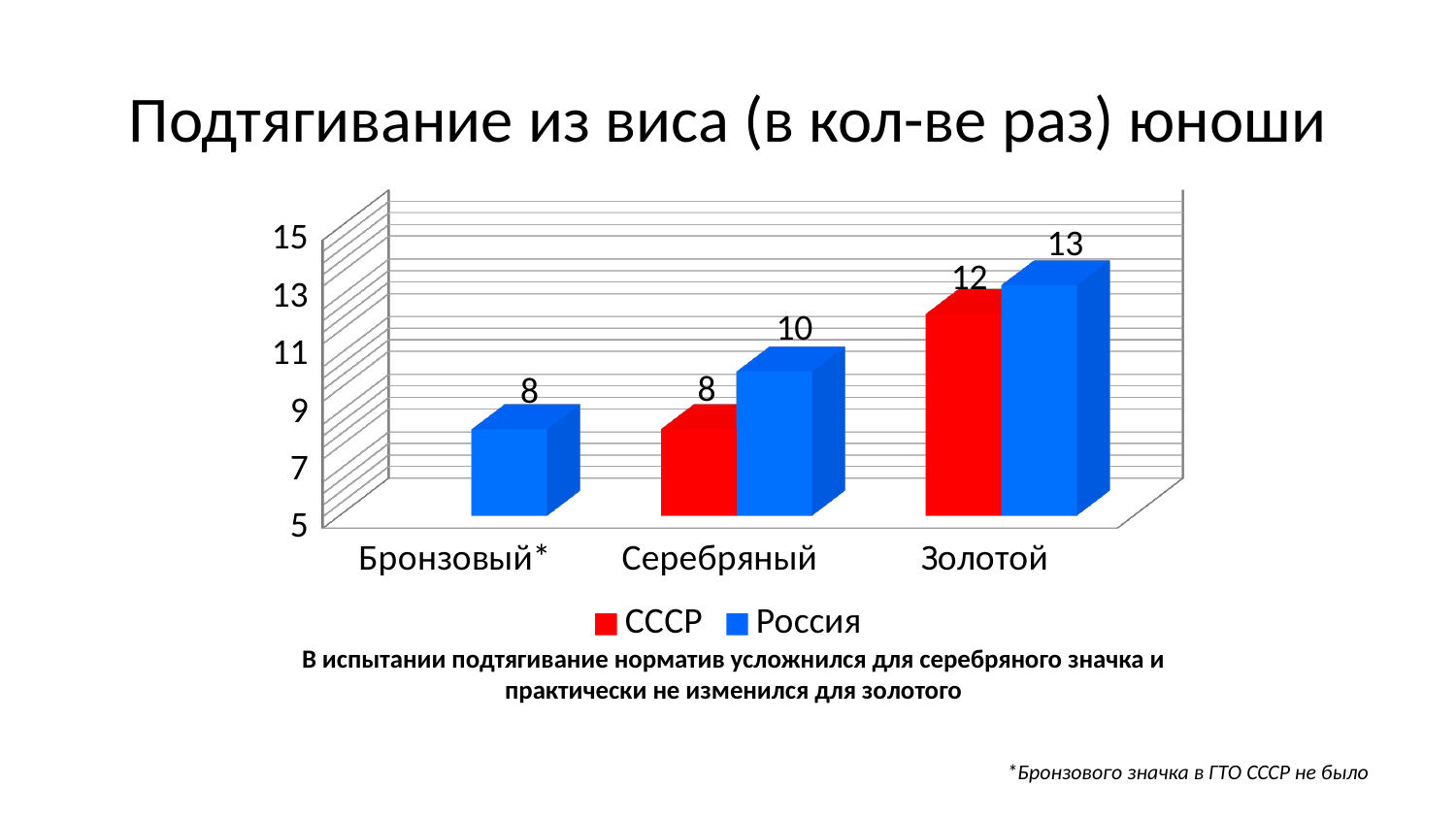
What is the value for СССР in the Серебряный category? 8 What is the value for Россия in the Бронзовый* category? 8 Do the values for Россия rise or fall from Бронзовый* to Золотой? Rise Which is larger in the Золотой category, the value for СССР or for Россия? Россия What kind of chart is shown on the slide? Bar chart What is the difference between the Россия and СССР values in the Серебряный category? 2 How many categories are shown on the x axis? 3 What is the value for СССР in the Золотой category? 12 What is the value for Россия in the Золотой category? 13 Which colour represents the СССР series in the legend? Red How many series does the legend list? 2 Which category has the highest value for Россия? Золотой